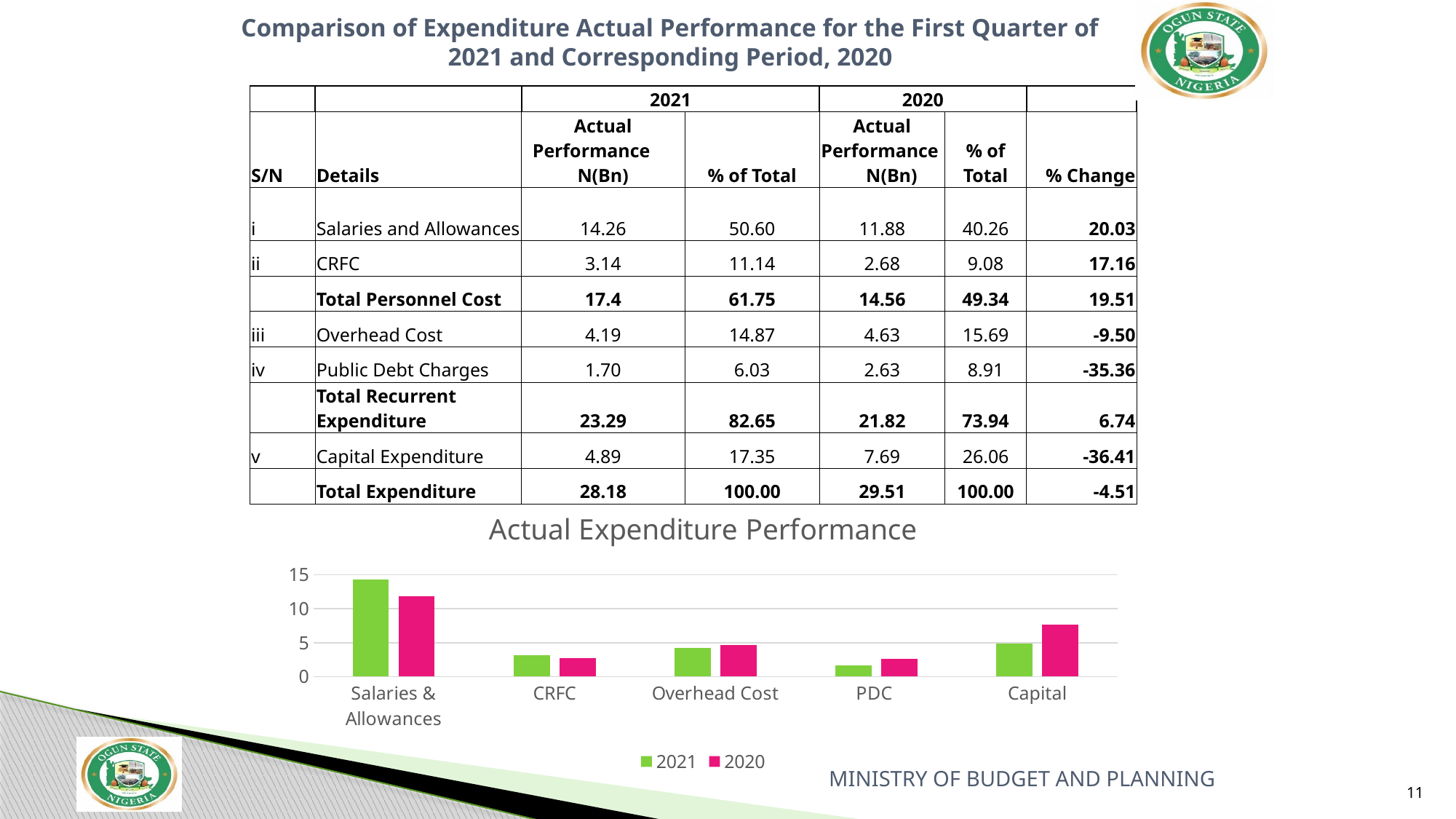
In the 'Actual Expenditure Performance' chart, is the 2020 value for Capital greater or less than 5? greater How many series does the legend of the 'Actual Expenditure Performance' chart list? 2 In the 'Actual Expenditure Performance' chart, which colour represents the 2020 series? pink What is the title of the bar chart on the slide? Actual Expenditure Performance What type of chart is shown under the title 'Actual Expenditure Performance'? bar chart In the 'Actual Expenditure Performance' chart, which is larger for Salaries & Allowances: the 2021 bar or the 2020 bar? 2021 How many categories are shown on the x axis of the 'Actual Expenditure Performance' chart? 5 In the 'Actual Expenditure Performance' chart, is the 2021 value for PDC greater or less than 5? less In the 'Actual Expenditure Performance' chart, is the 2021 value for Salaries & Allowances greater or less than 10? greater In the 'Actual Expenditure Performance' chart, which is larger for Capital: the 2021 bar or the 2020 bar? 2020 In the 'Actual Expenditure Performance' chart, which category has the highest 2021 bar? Salaries & Allowances In the 'Actual Expenditure Performance' chart, which category has the lowest 2021 bar? PDC